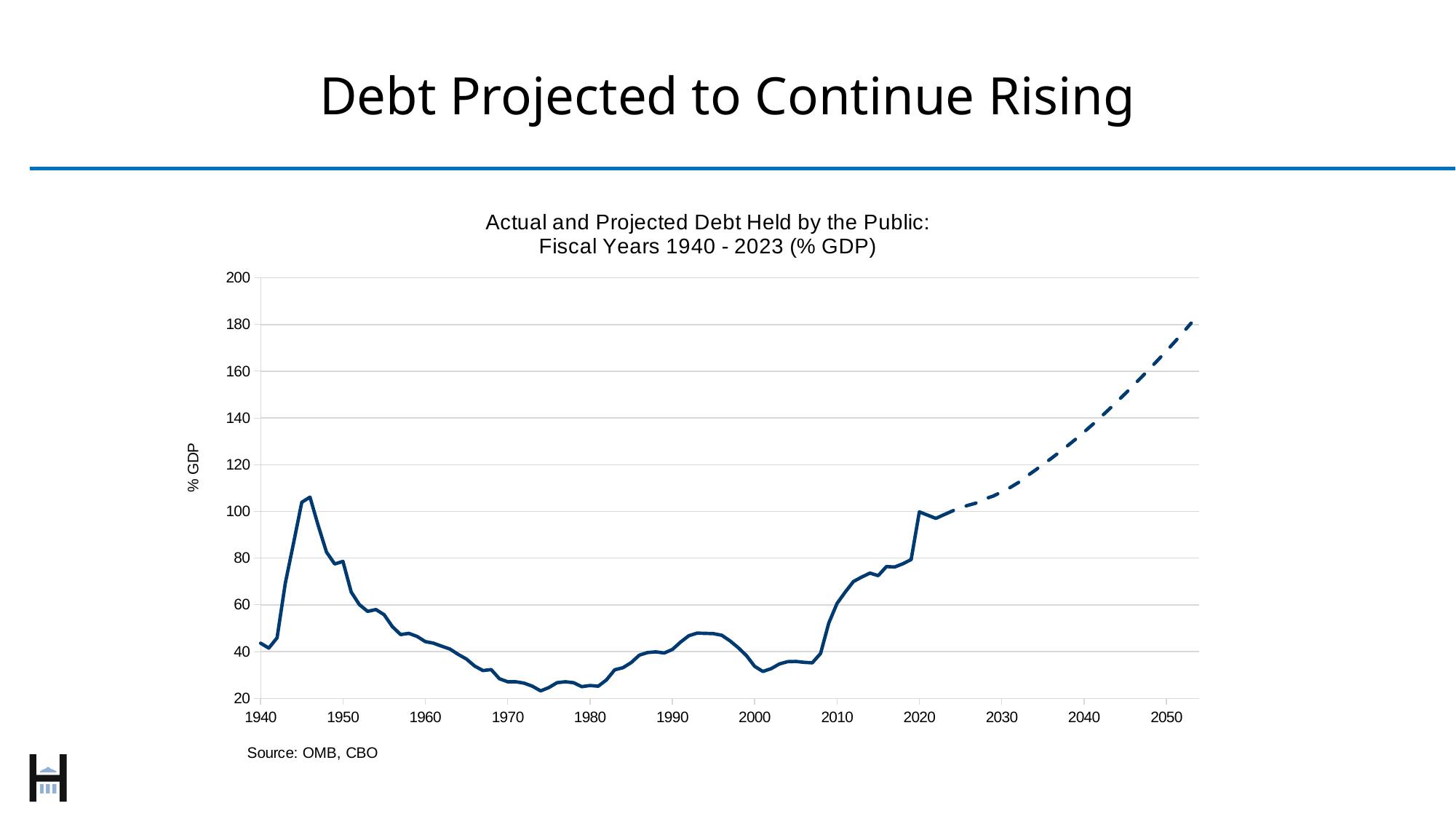
Does the line rise or fall between 2007 and 2012? rise Does the projected (dashed) line rise or fall from 2024 to 2053? rise Is the value for 1974 greater or less than 40? less Is the value for 1946 greater or less than 100? greater Does the line rise or fall between 1946 and 1974? fall Is the value for 1980 greater or less than 40? less What is the title of the chart? Actual and Projected Debt Held by the Public: Fiscal Years 1940 - 2023 (% GDP) What is the label on the y axis of the chart? % GDP What kind of chart is shown on the slide? line chart